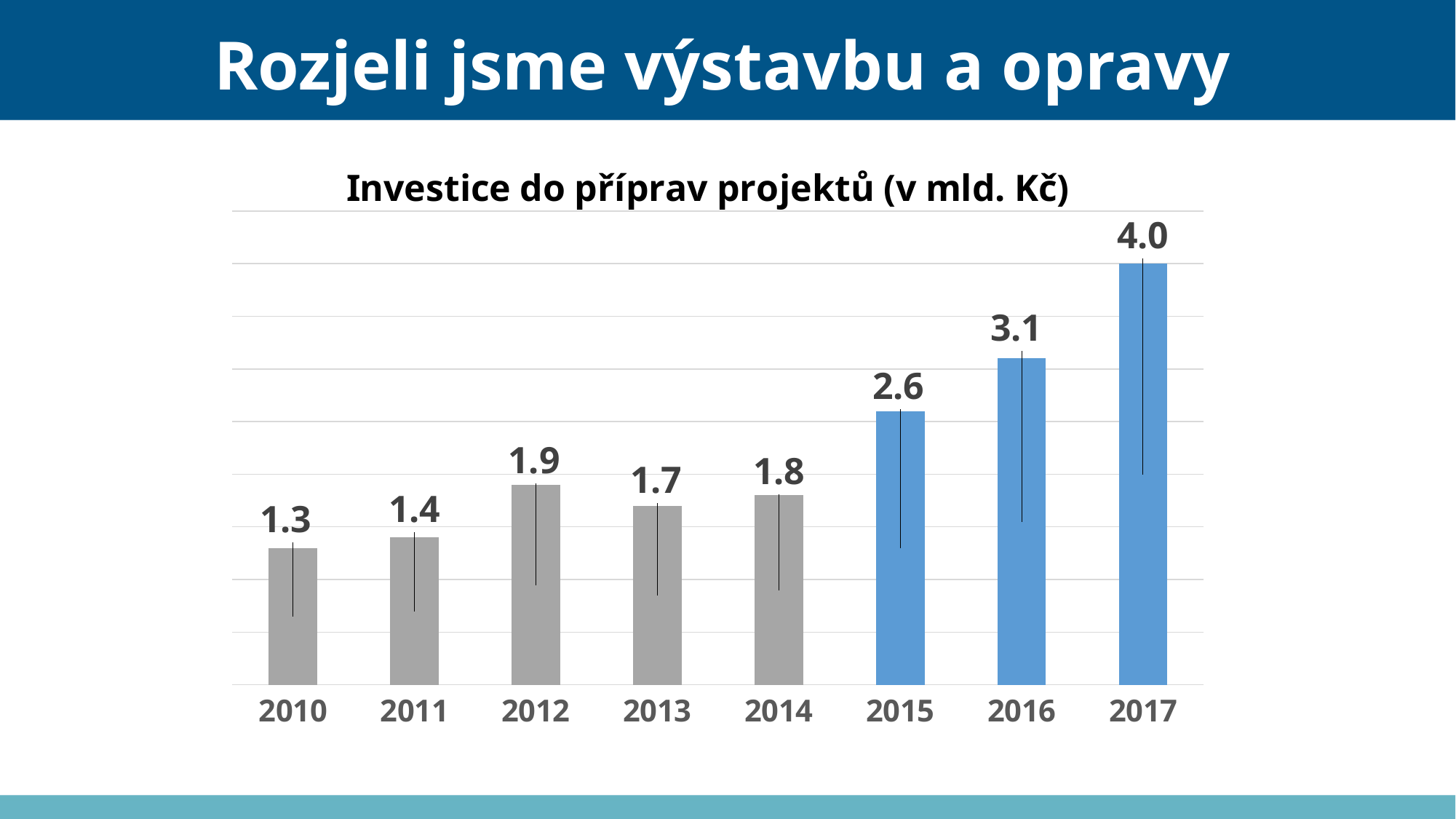
How many years are shown on the x axis? 8 Do the values generally rise or fall from 2014 to 2017? rise What is the title of the chart? Investice do příprav projektů (v mld. Kč) What is the value for 2017? 4.0 What is the value for 2010? 1.3 Which is larger, the value for 2012 or the value for 2013? 2012 Which year has the lowest value? 2010 Which year has the highest value? 2017 What is the value for 2013? 1.7 What is the difference between the values for 2017 and 2010? 2.7 What kind of chart is shown? bar chart What is the difference between the values for 2016 and 2015? 0.5